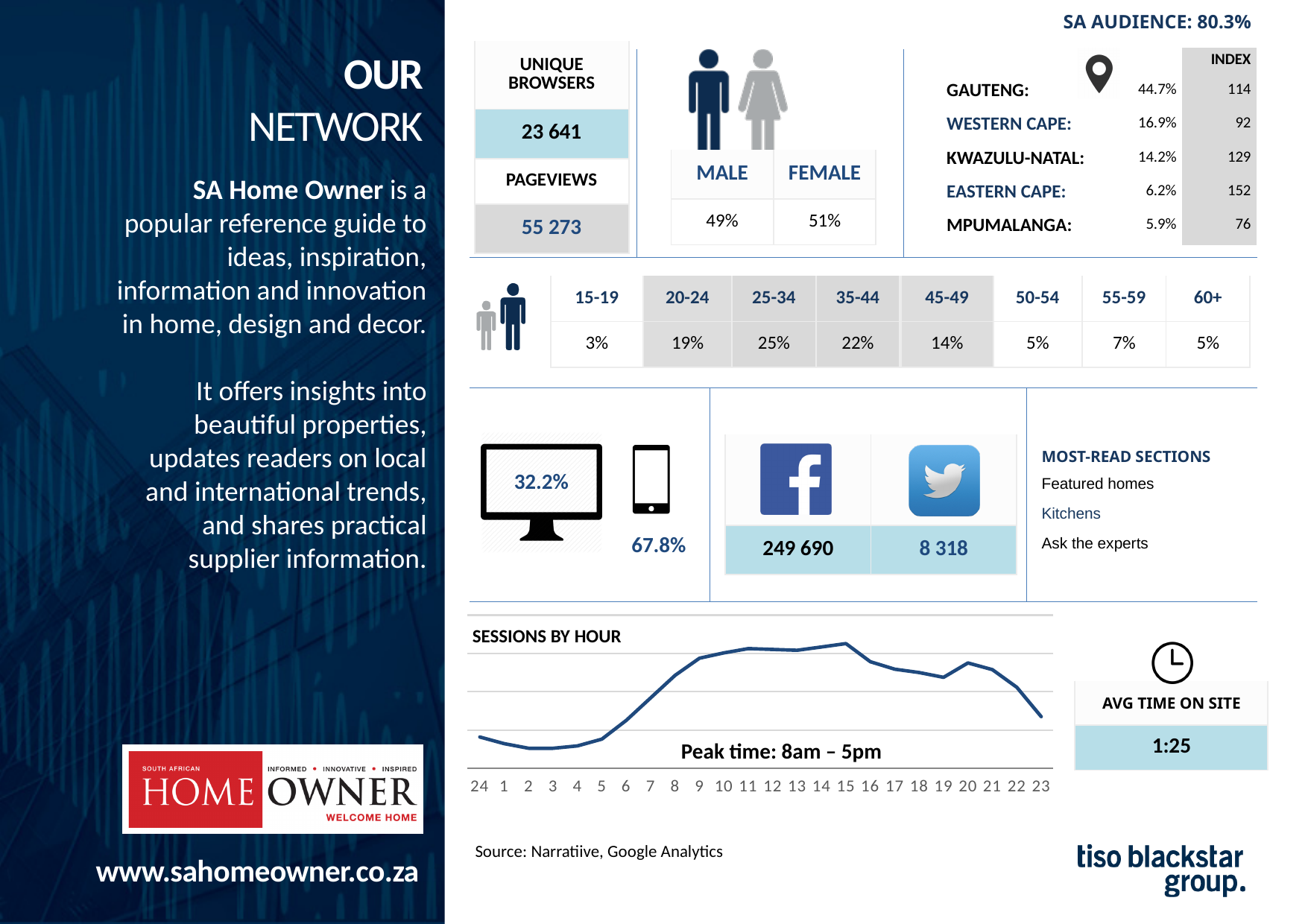
What is the title of the line chart at the bottom of the slide? SESSIONS BY HOUR How many lines are plotted on the 'Sessions by Hour' chart? 1 In the 'Sessions by Hour' chart, do sessions rise or fall between hour 5 and hour 9? rise In the 'Sessions by Hour' chart, is the value at hour 9 larger or smaller than the value at hour 3? larger In the 'Sessions by Hour' chart, which hour has the larger value, 15 or 23? 15 How many hour points are labelled on the x axis of the 'Sessions by Hour' chart? 24 What peak time is stated on the 'Sessions by Hour' chart? 8am – 5pm In the 'Sessions by Hour' chart, do sessions rise or fall between hour 15 and hour 23? fall In the 'Sessions by Hour' chart, at which hour does the line reach its highest point? 15 What kind of chart is the 'Sessions by Hour' chart? line chart